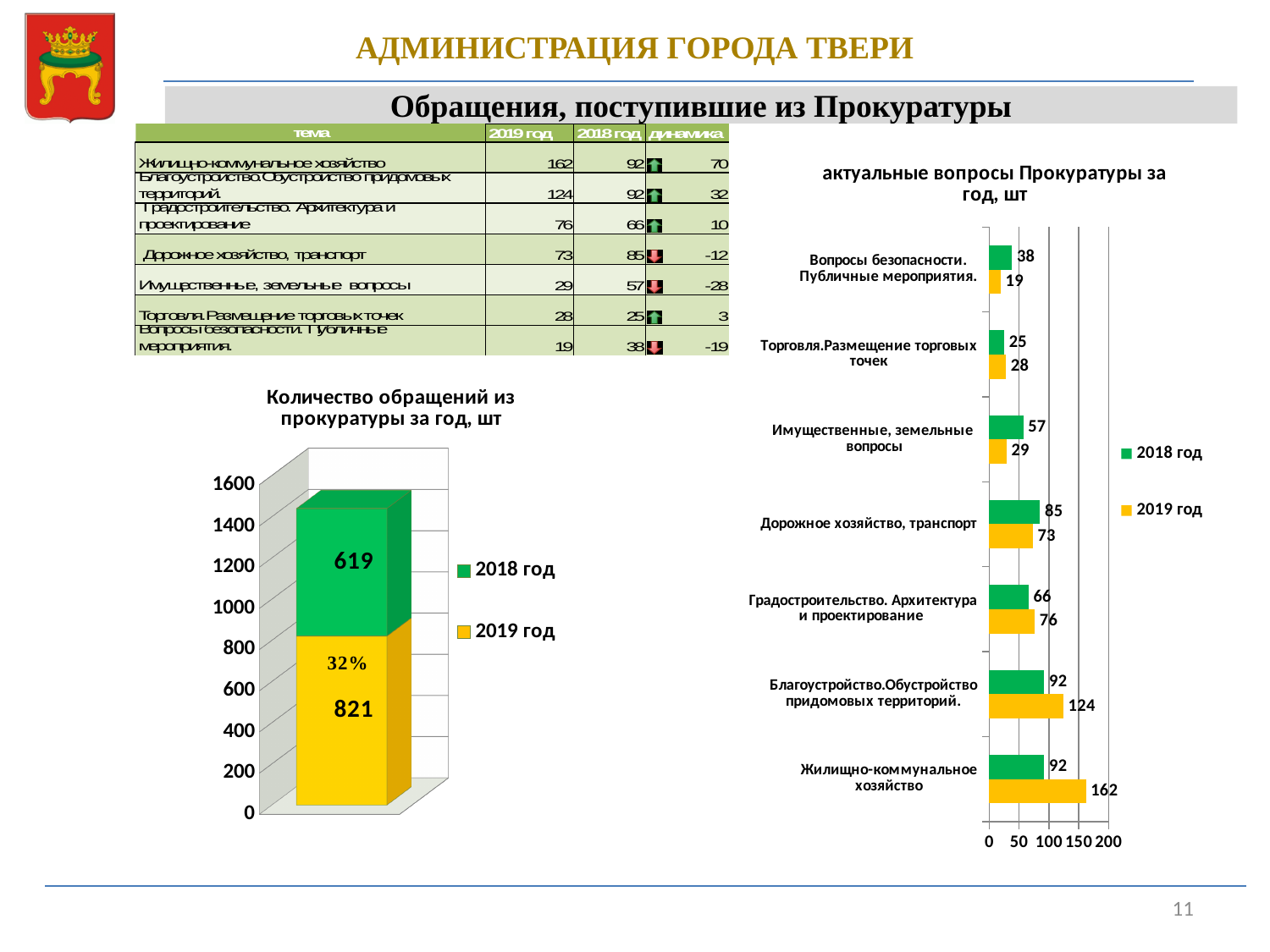
In the chart titled "актуальные вопросы Прокуратуры за год, шт", how many series does the legend list? 2 In the chart titled "Количество обращений из прокуратуры за год, шт", what is the value for 2018 год? 619 In the chart titled "актуальные вопросы Прокуратуры за год, шт", which category has the highest 2019 год value? Жилищно-коммунальное хозяйство In the chart titled "актуальные вопросы Прокуратуры за год, шт", which category has the lowest 2019 год value? Вопросы безопасности. Публичные мероприятия. In the chart titled "актуальные вопросы Прокуратуры за год, шт", how many categories are shown? 7 In the chart titled "Количество обращений из прокуратуры за год, шт", what kind of chart is shown? Stacked bar chart In the chart titled "актуальные вопросы Прокуратуры за год, шт", what is the 2019 год value for Жилищно-коммунальное хозяйство? 162 In the chart titled "Количество обращений из прокуратуры за год, шт", what is the value for 2019 год? 821 In the chart titled "актуальные вопросы Прокуратуры за год, шт", what is the difference between the 2019 год and 2018 год values for Благоустройство.Обустройство придомовых территорий.? 32 In the chart titled "актуальные вопросы Прокуратуры за год, шт", what is the 2018 год value for Дорожное хозяйство, транспорт? 85 In the chart titled "Количество обращений из прокуратуры за год, шт", what is the total of the stacked bar? 1440 In the chart titled "актуальные вопросы Прокуратуры за год, шт", which is larger for Имущественные, земельные вопросы: the 2018 год value or the 2019 год value? 2018 год